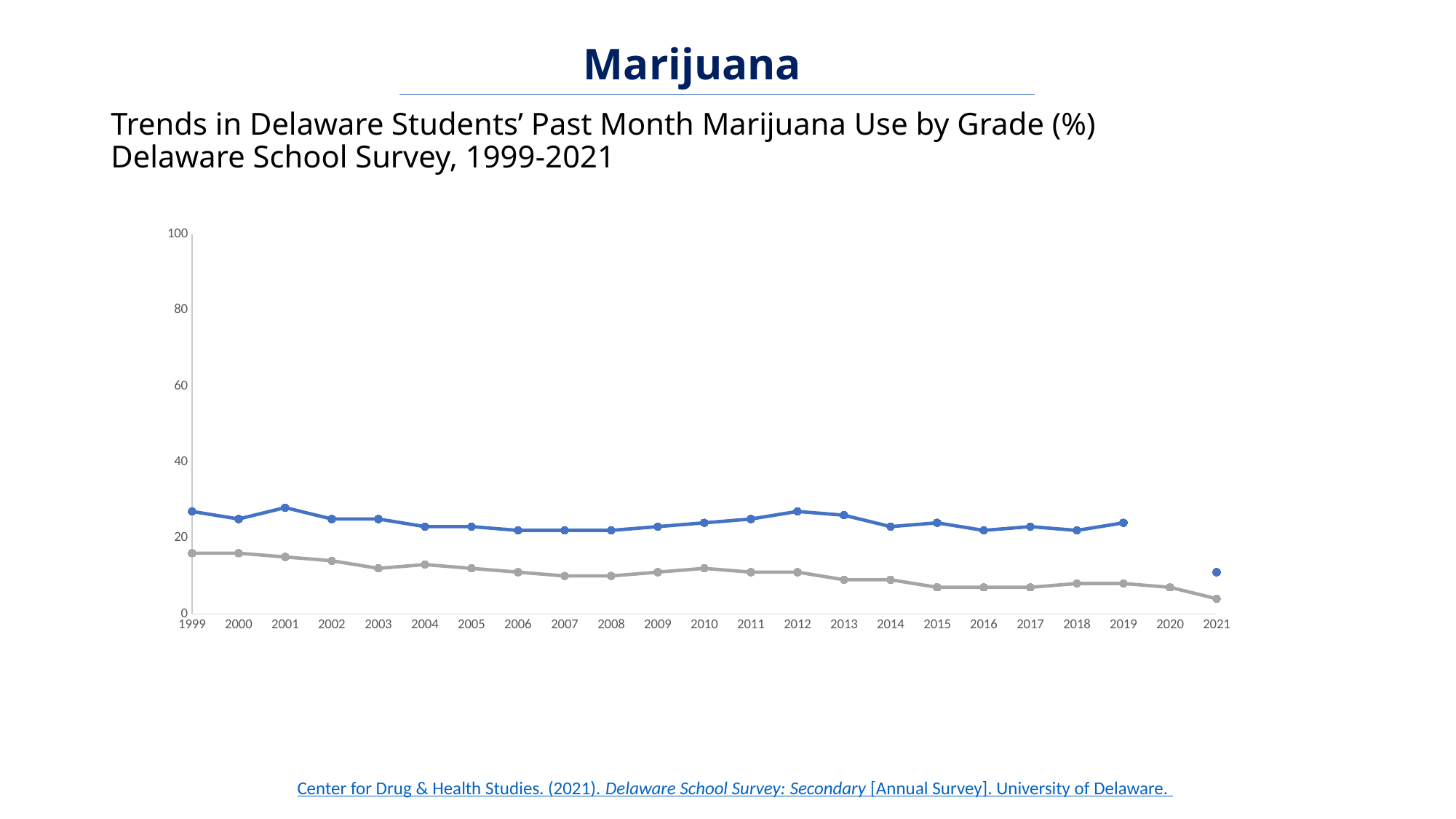
How many lines (series) are plotted on the chart? 2 What is the title of the chart on the slide? Trends in Delaware Students' Past Month Marijuana Use by Grade (%) Is the value of the blue line in 2012 greater or less than 40? less Is the value of the blue point in 2021 greater or less than 20? less Does the gray line rise or fall overall from 1999 to 2021? fall Is the value of the gray line in 2021 greater or less than 20? less In 2010, which line has the higher value, the blue line or the gray line? the blue line In which year does the gray line reach its lowest value? 2021 What kind of chart is shown on the slide? line chart How many years are labelled along the x axis of the chart? 23